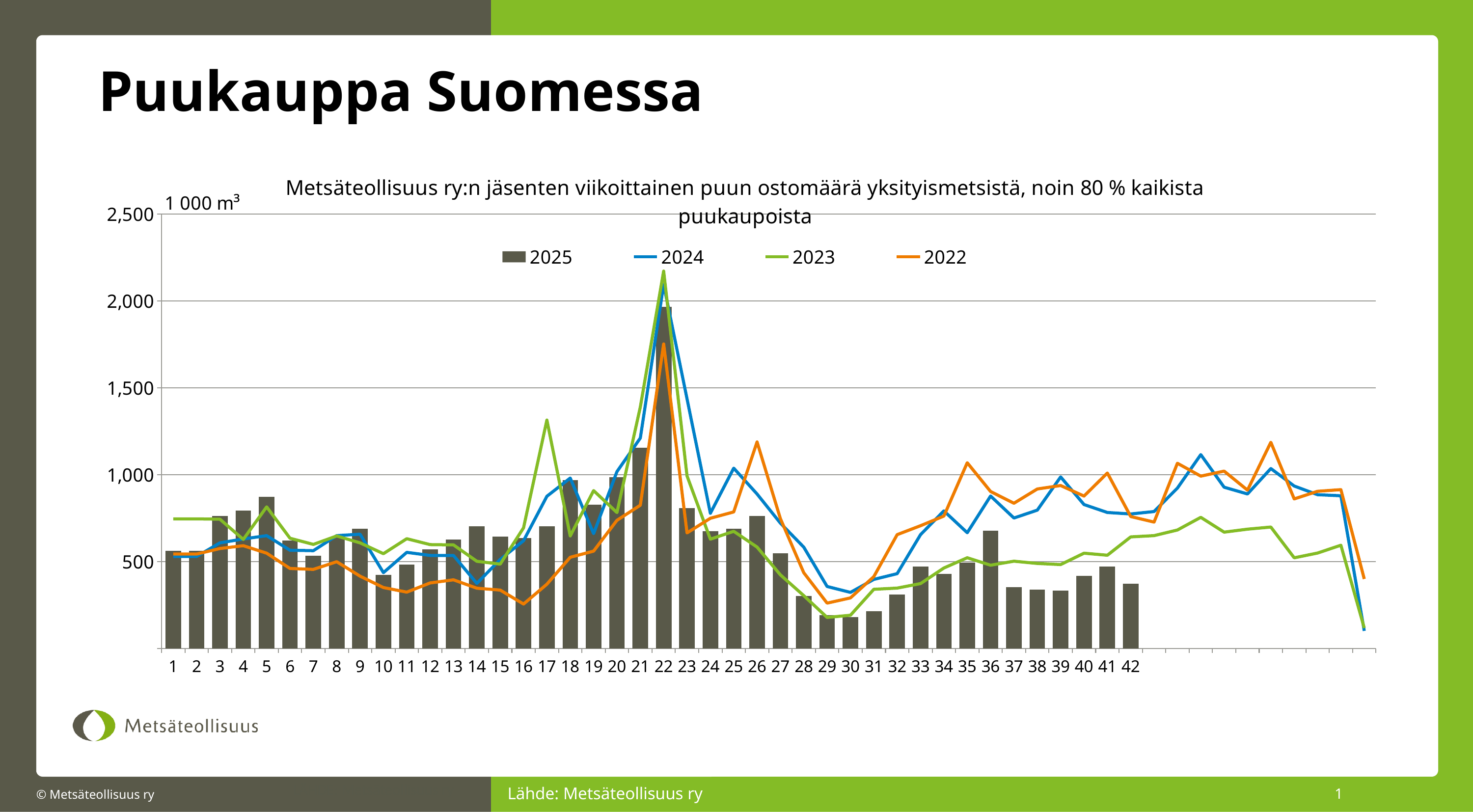
In which week is the 2025 bar highest? 22 Is the 2025 value for week 5 greater or less than 500? greater Is the 2025 value for week 22 greater or less than 1,500? greater Do the 2025 bars rise or fall from week 22 to week 29? fall Which series is drawn as bars rather than a line? 2025 What kind of chart is shown on the slide? A combined bar and line chart Is the 2022 value for week 26 greater or less than 1,000? greater What unit is shown at the top of the y axis? 1 000 m³ Which 2025 bar is taller, week 36 or week 37? Week 36 How many series does the chart legend list? 4 How many weeks have a 2025 bar plotted? 42